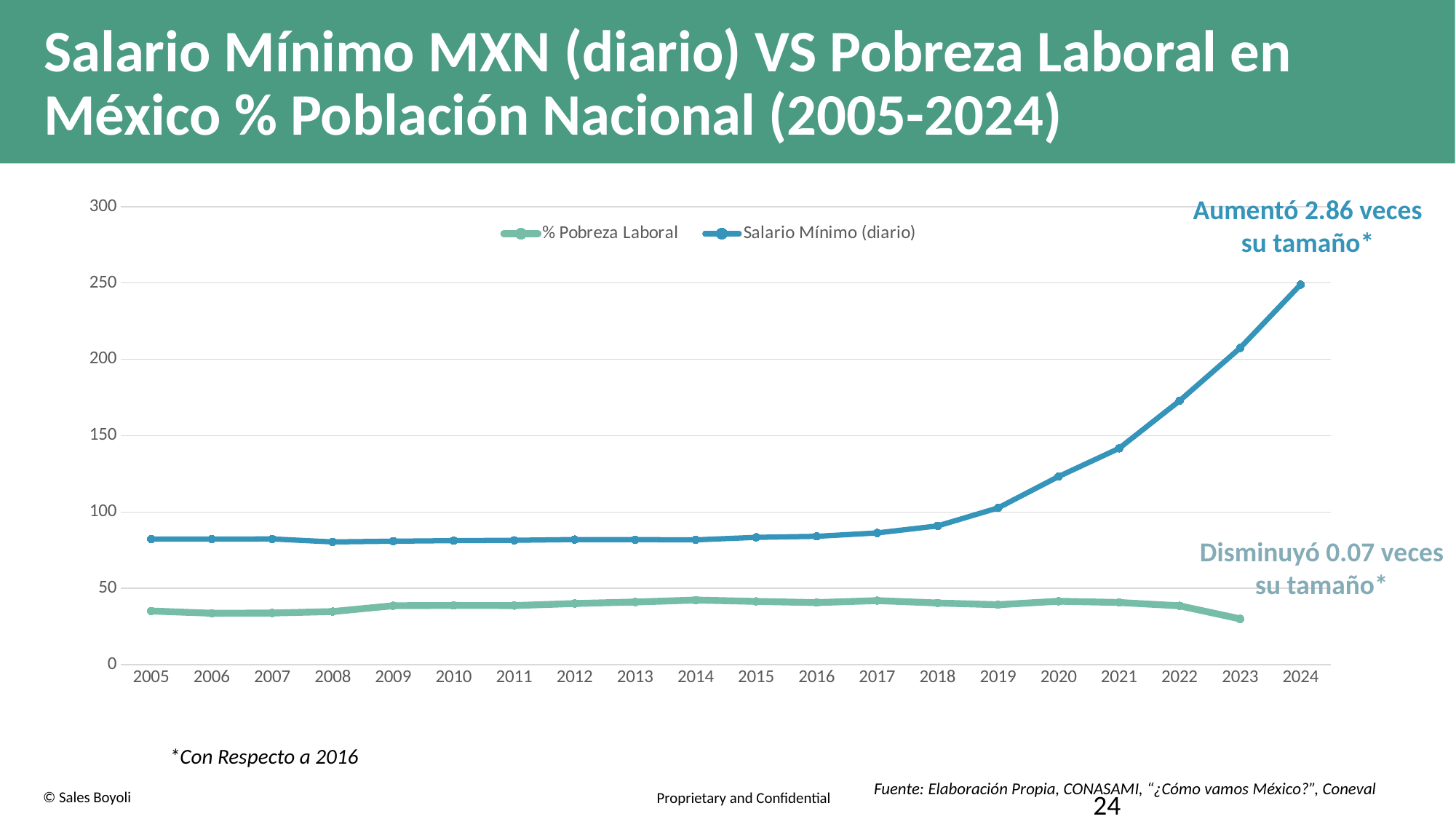
Is the value for Salario Mínimo (diario) in 2022 greater or less than 150? greater What kind of chart is shown on the slide? Line chart Is the value for Salario Mínimo (diario) in 2024 greater or less than 200? greater Is the value for Salario Mínimo (diario) in 2005 greater or less than 100? less In which year is the % Pobreza Laboral lowest? 2023 According to the annotation, by how many times did the Salario Mínimo increase in size? 2.86 veces How many years are shown along the x axis? 20 Does the Salario Mínimo (diario) line rise or fall from 2018 to 2024? Rise How many series does the legend list? 2 In which year is the Salario Mínimo (diario) highest? 2024 Which series does the blue line represent? Salario Mínimo (diario)